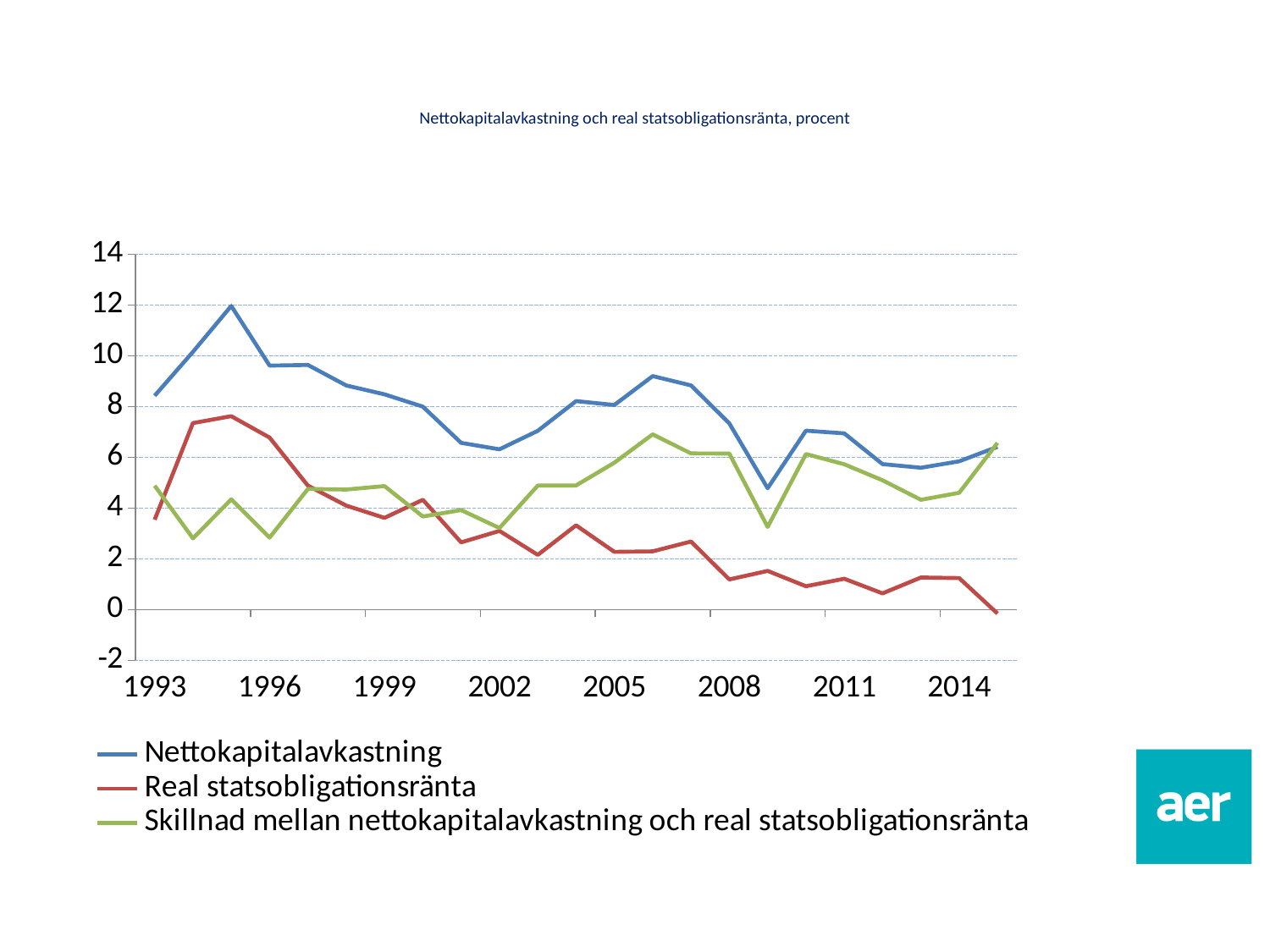
In which year is Real statsobligationsränta at its lowest? 2015 What kind of chart is shown on the slide? line chart Does Real statsobligationsränta generally rise or fall between 1995 and 2015? fall In 1993, which is larger: Nettokapitalavkastning or Real statsobligationsränta? Nettokapitalavkastning What is the title of the chart? Nettokapitalavkastning och real statsobligationsränta, procent How many series does the legend list? 3 Is the value for Real statsobligationsränta in 2008 greater or less than 2? less Which series is drawn in green? Skillnad mellan nettokapitalavkastning och real statsobligationsränta Is the value for Nettokapitalavkastning in 2009 greater or less than 6? less In which year does Nettokapitalavkastning reach its highest value? 1995 Is the value for Nettokapitalavkastning in 1993 greater or less than 8? greater